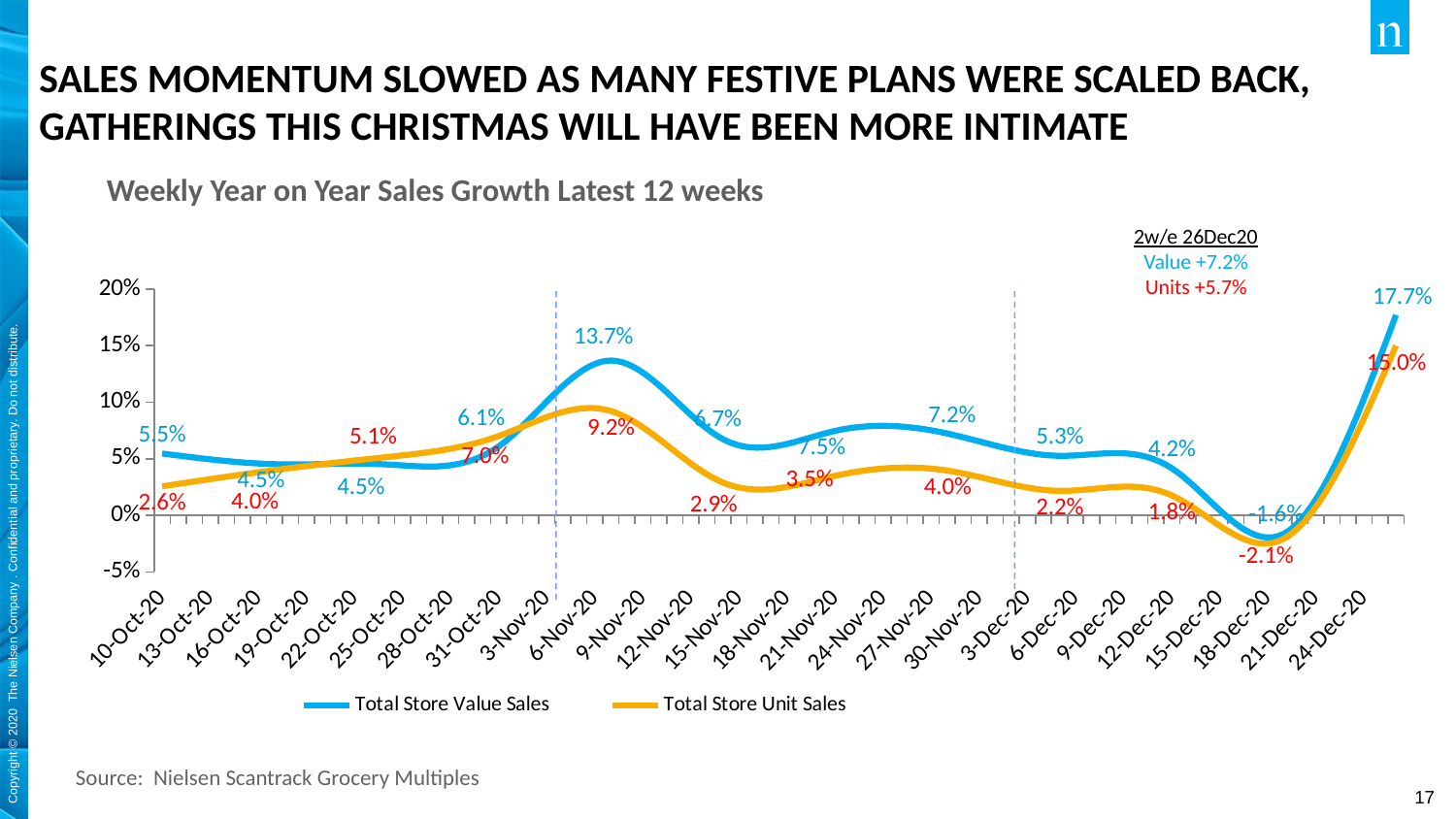
What is the highest value labelled on the Total Store Value Sales line? 17.7% What is the labelled value of the early-November peak on the Total Store Value Sales line? 13.7% What is the highest value labelled on the Total Store Unit Sales line? 15.0% What is the title of the chart? Weekly Year on Year Sales Growth Latest 12 weeks What is the lowest value labelled on the Total Store Value Sales line? -1.6% What Value growth is given in the annotation for 2w/e 26Dec20? +7.2% At the final data point on the right of the chart, which series is higher: Total Store Value Sales or Total Store Unit Sales? Total Store Value Sales How many series does the legend list? 2 What is the difference between the final labelled values of Total Store Value Sales (17.7%) and Total Store Unit Sales (15.0%)? 2.7 percentage points What type of chart is shown on the slide? Line chart What are the two series named in the legend? Total Store Value Sales and Total Store Unit Sales What is the lowest value labelled on the Total Store Unit Sales line? -2.1%